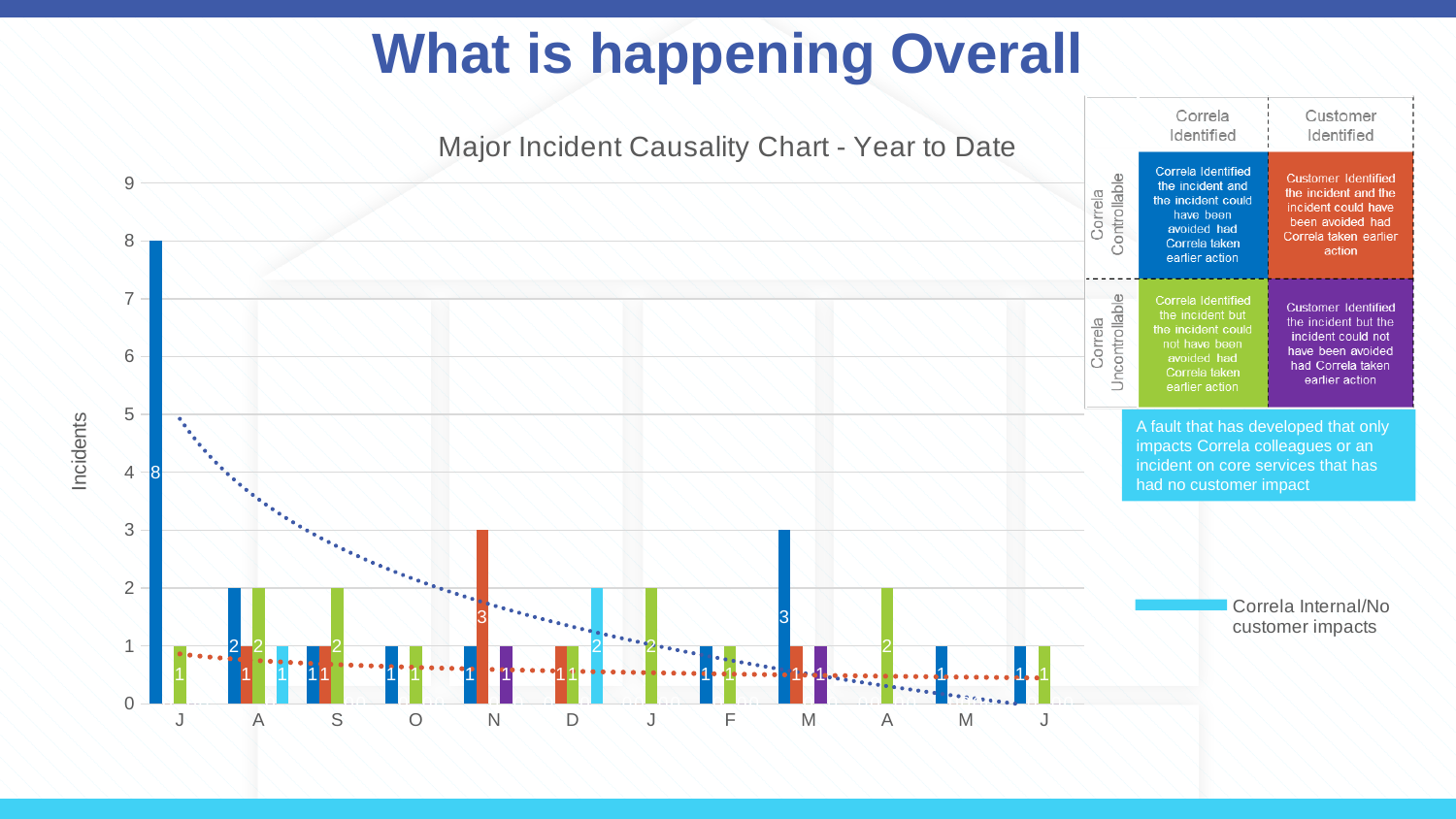
Does the dotted blue trend line rise or fall from left to right across the chart? fall How many month categories are shown on the x axis? 12 Is the tallest bar in the chart greater or less than 5? greater What is the value of the dark blue bar in the month M (the first M)? 3 What is the value of the orange bar in the month N? 3 What is the difference between the dark blue bar in the first J month (8) and the orange bar in N (3)? 5 What is the value of the light blue bar in the month D? 2 In which month category does the tallest bar appear? J (the first month) What is the value of the tallest bar in the chart? 8 What is the title of the chart on the slide? Major Incident Causality Chart - Year to Date What kind of chart is the Major Incident Causality Chart? bar chart What is the label on the vertical axis of the chart? Incidents